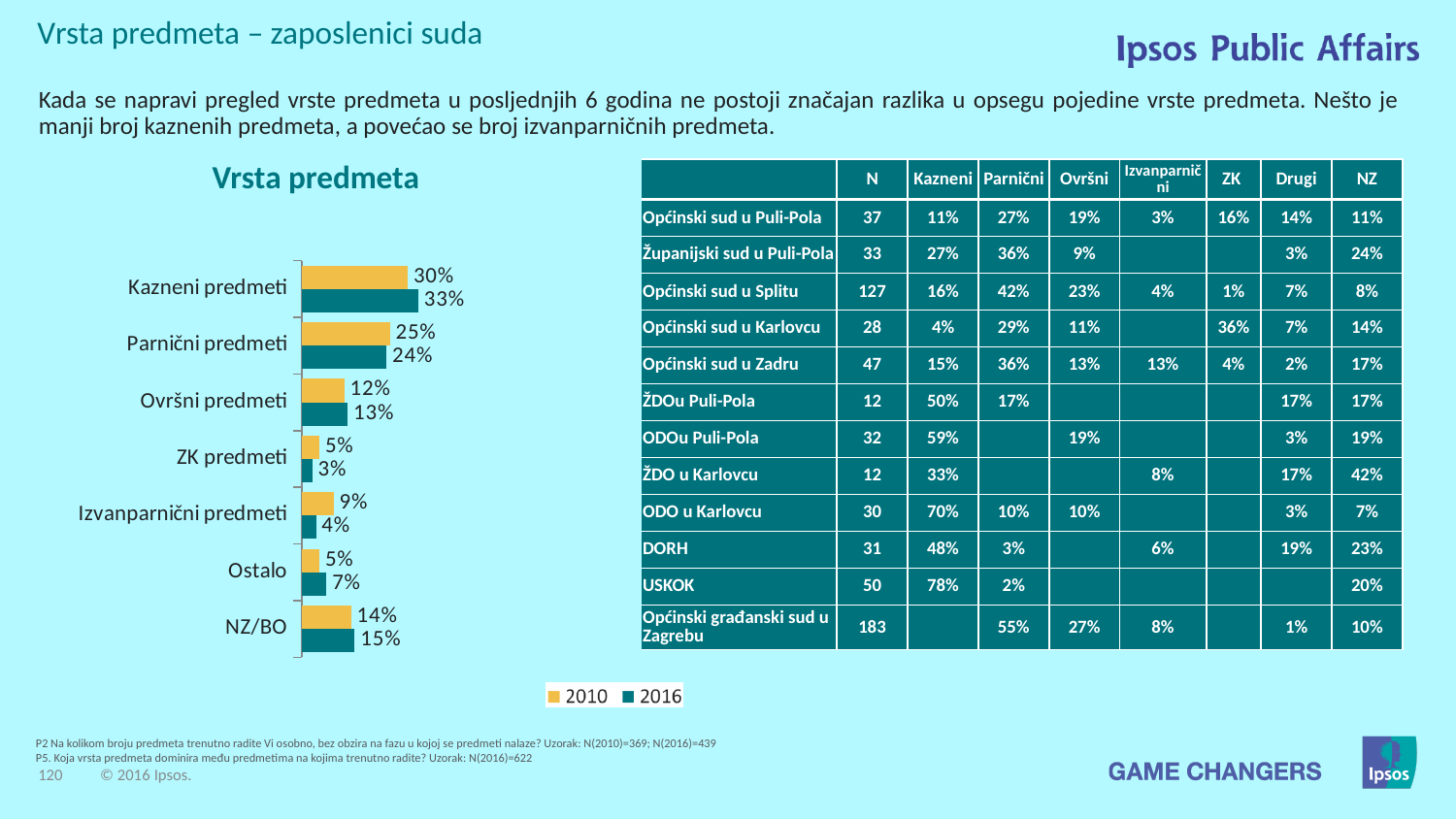
What is the value for NZ/BO in the 2016 series? 15% What is the value for Ostalo in the 2010 series? 5% What is the title of the chart? Vrsta predmeta What is the value for Kazneni predmeti in the 2016 series? 33% How many series does the legend list? 2 How many categories are shown in the chart? 7 What is the value for Izvanparnični predmeti in the 2010 series? 9% Which category has the lowest value in the 2016 series? ZK predmeti Which category has the highest value in the 2010 series? Kazneni predmeti What is the difference between the 2010 and 2016 values for Izvanparnični predmeti? 5% Which is larger for Parnični predmeti, the 2010 value or the 2016 value? 2010 What kind of chart is shown on the slide? Bar chart